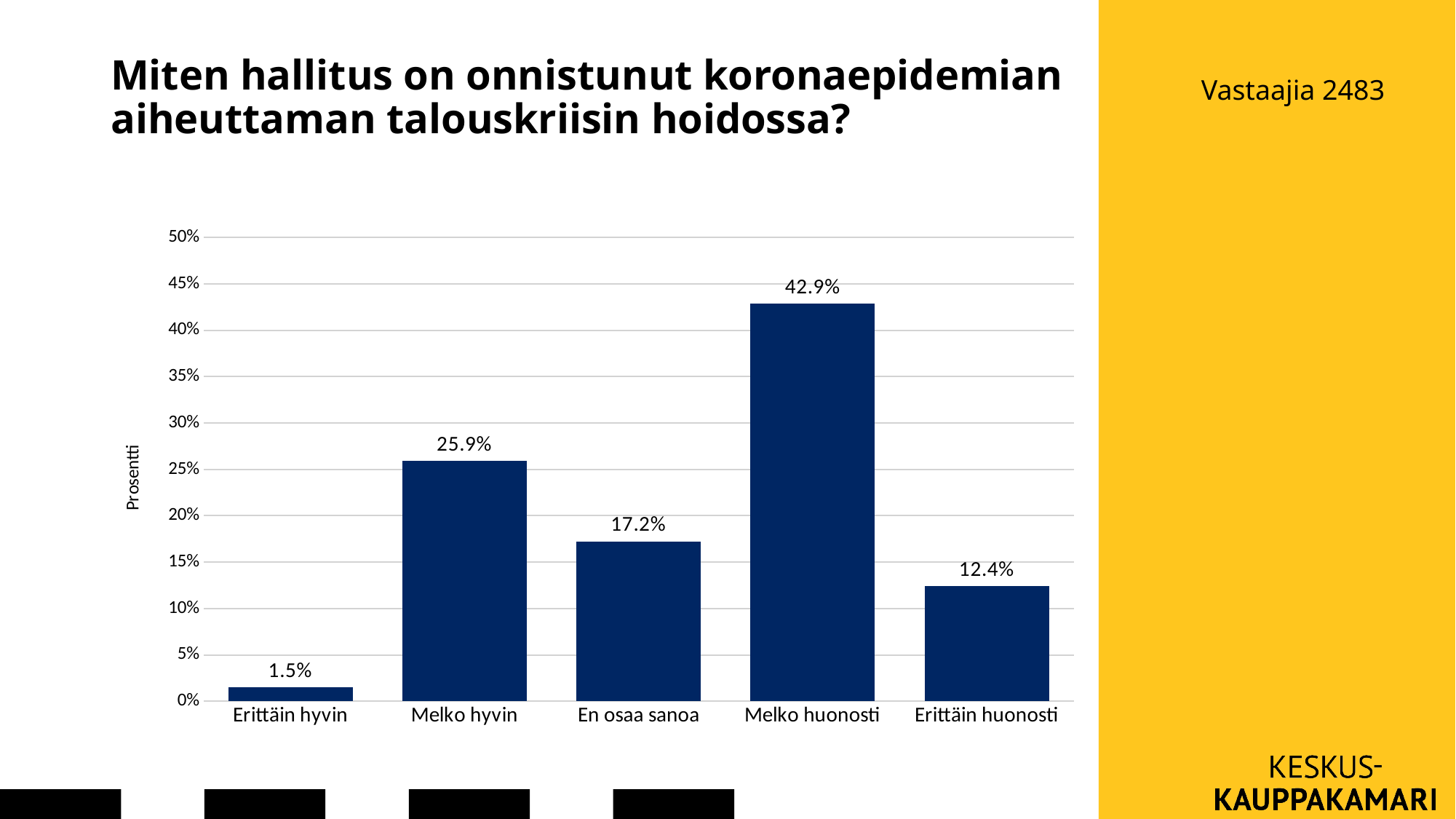
What is the value for Erittäin hyvin? 1.5% Which category has the highest value? Melko huonosti What is the label of the y axis? Prosentti Is the value for Melko huonosti greater or less than 40%? greater What is the value for Melko huonosti? 42.9% Which is larger, the value for Melko hyvin or the value for Erittäin huonosti? Melko hyvin What is the difference between the values for Melko huonosti and Melko hyvin? 17.0% What is the value for En osaa sanoa? 17.2% What is the difference between the values for En osaa sanoa and Erittäin huonosti? 4.8% How many categories are shown on the x axis? 5 What kind of chart is shown on the slide? bar chart Which category has the lowest value? Erittäin hyvin